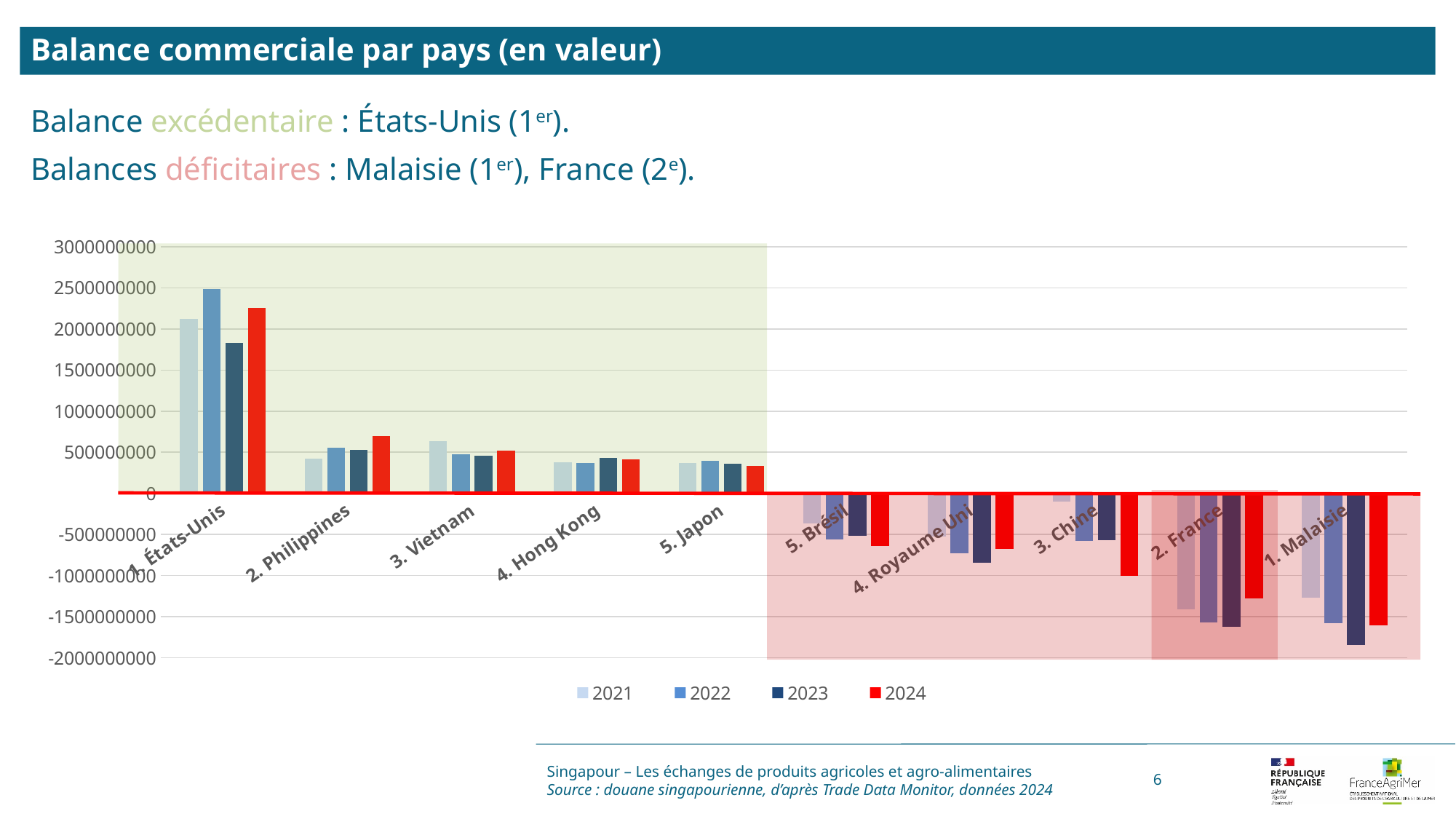
Is the 2023 value for États-Unis greater or less than 2000000000? less Is the 2021 value for Brésil greater or less than -500000000? greater How many countries are shown on the x axis of the chart? 10 What kind of chart is shown on the slide? bar chart Which country has the highest trade balance in 2024? 1. États-Unis Which country has the lowest trade balance in 2024? 1. Malaisie Is the 2022 value for États-Unis greater or less than 2000000000? greater For États-Unis, which year has the larger value: 2022 or 2024? 2022 How many series does the chart legend list? 4 Which colour represents the 2024 series in the legend? red